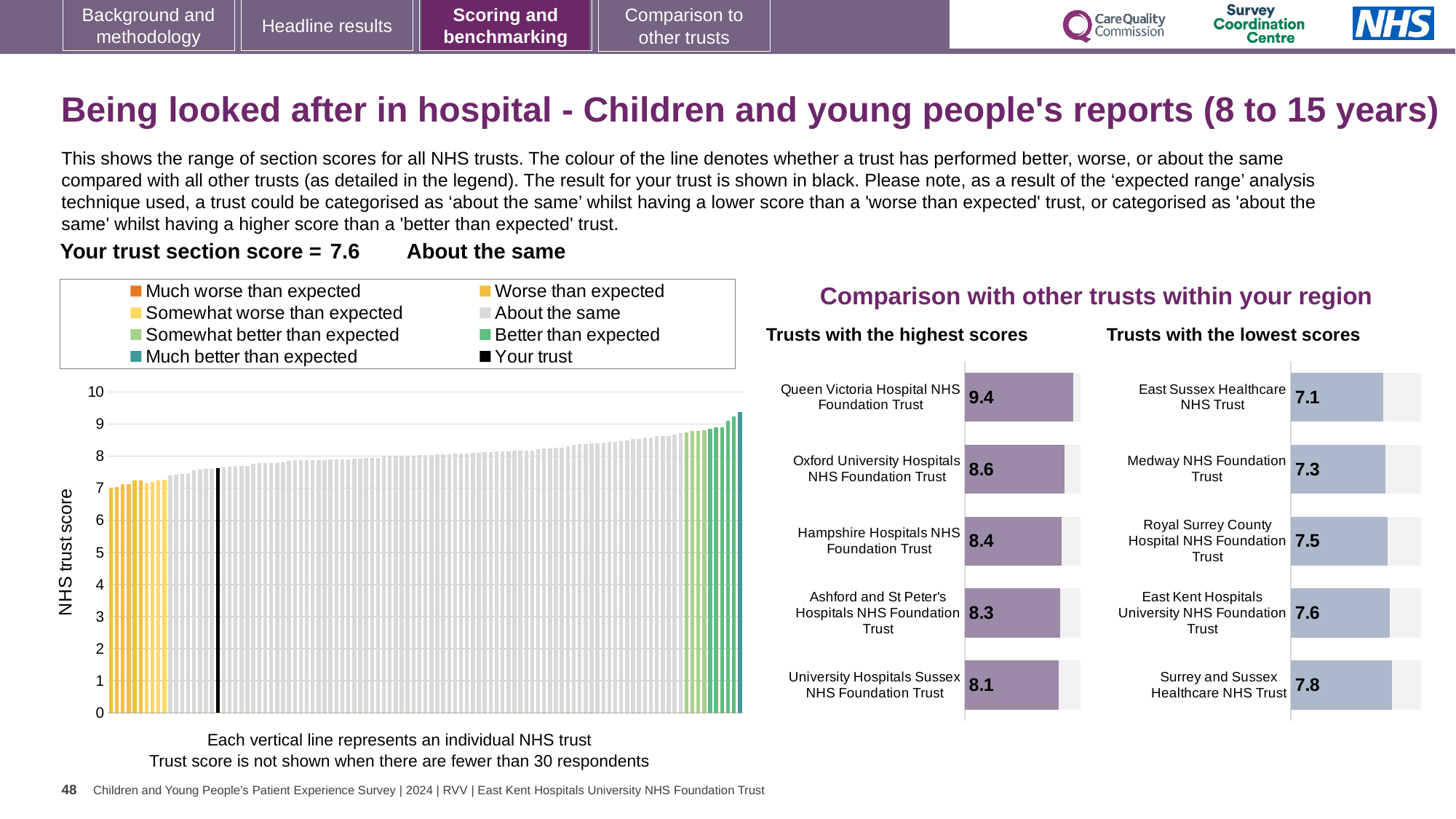
In the 'Trusts with the highest scores' chart, what is the difference between the scores of Queen Victoria Hospital NHS Foundation Trust and Oxford University Hospitals NHS Foundation Trust? 0.8 How many entries does the legend of the main 'NHS trust score' chart list? 8 In the 'Trusts with the highest scores' chart, which trust has the lowest score shown? University Hospitals Sussex NHS Foundation Trust In the main 'NHS trust score' chart on the left, is the value of the highest bar greater or less than 9? greater In the 'Trusts with the lowest scores' chart, which trust has the lowest score? East Sussex Healthcare NHS Trust How many trusts are shown in the 'Trusts with the lowest scores' chart? 5 In the 'Trusts with the highest scores' chart, what is the score for Queen Victoria Hospital NHS Foundation Trust? 9.4 In the main 'NHS trust score' chart on the left, what is the section score for your trust (the black line)? 7.6 In the 'Trusts with the highest scores' chart, what is the score for Hampshire Hospitals NHS Foundation Trust? 8.4 In the 'Trusts with the lowest scores' chart, what is the score for Medway NHS Foundation Trust? 7.3 In the 'Trusts with the lowest scores' chart, which has the higher score: Royal Surrey County Hospital NHS Foundation Trust or Surrey and Sussex Healthcare NHS Trust? Surrey and Sussex Healthcare NHS Trust In the main 'NHS trust score' chart on the left, do the values rise or fall from left to right? rise